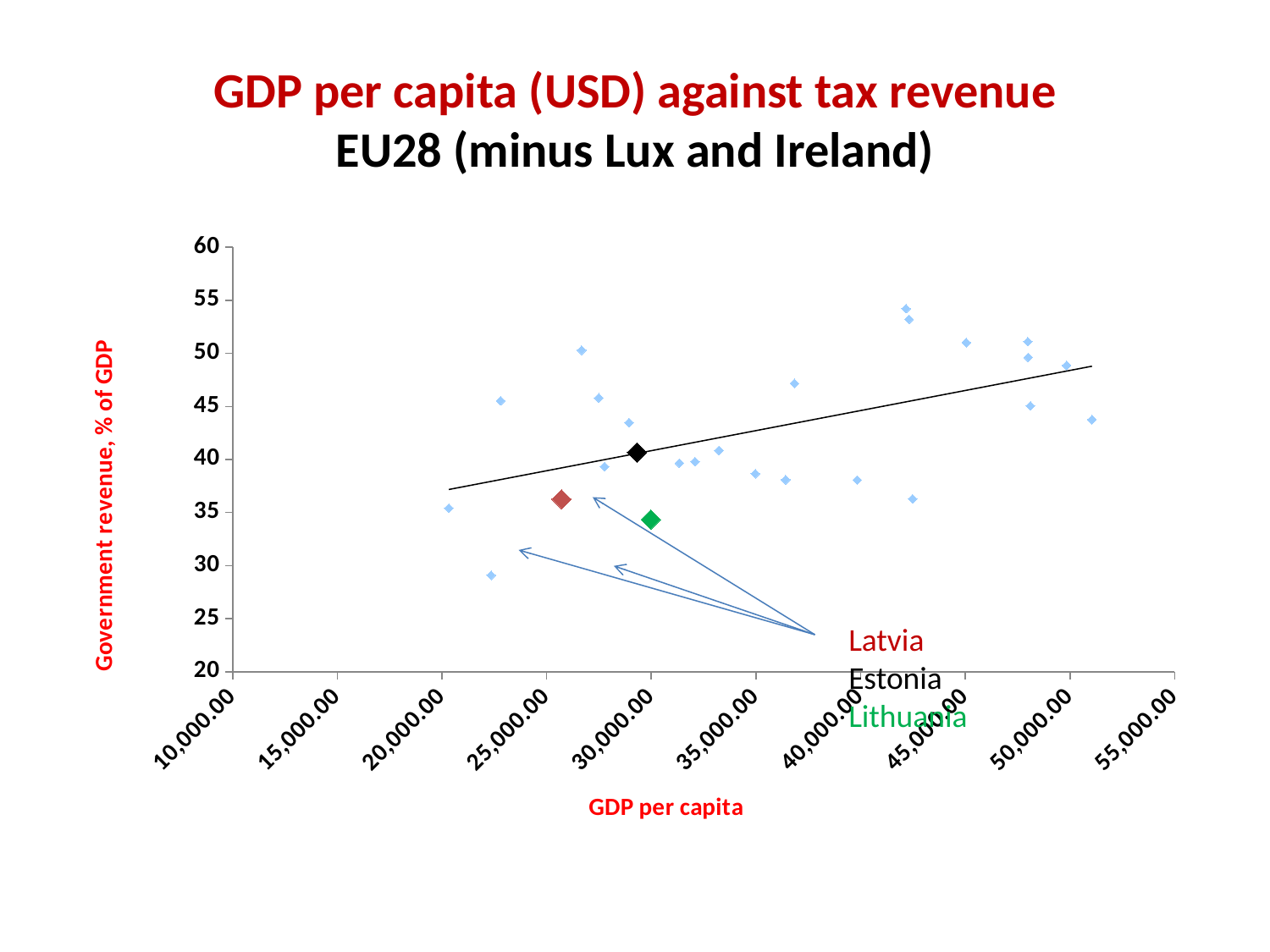
Is the government revenue value for Latvia greater or less than 40? less Is the government revenue value for Estonia greater or less than 35? greater Which has the higher GDP per capita, Latvia or Estonia? Estonia Is the GDP per capita value for Estonia greater or less than 25,000.00? greater Which has the higher government revenue as % of GDP, Estonia or Lithuania? Estonia Does the fitted trend line rise or fall as GDP per capita increases? rises What colour is the marker used for Lithuania? green What kind of chart is shown on the slide? scatter chart What is the label of the vertical axis? Government revenue, % of GDP